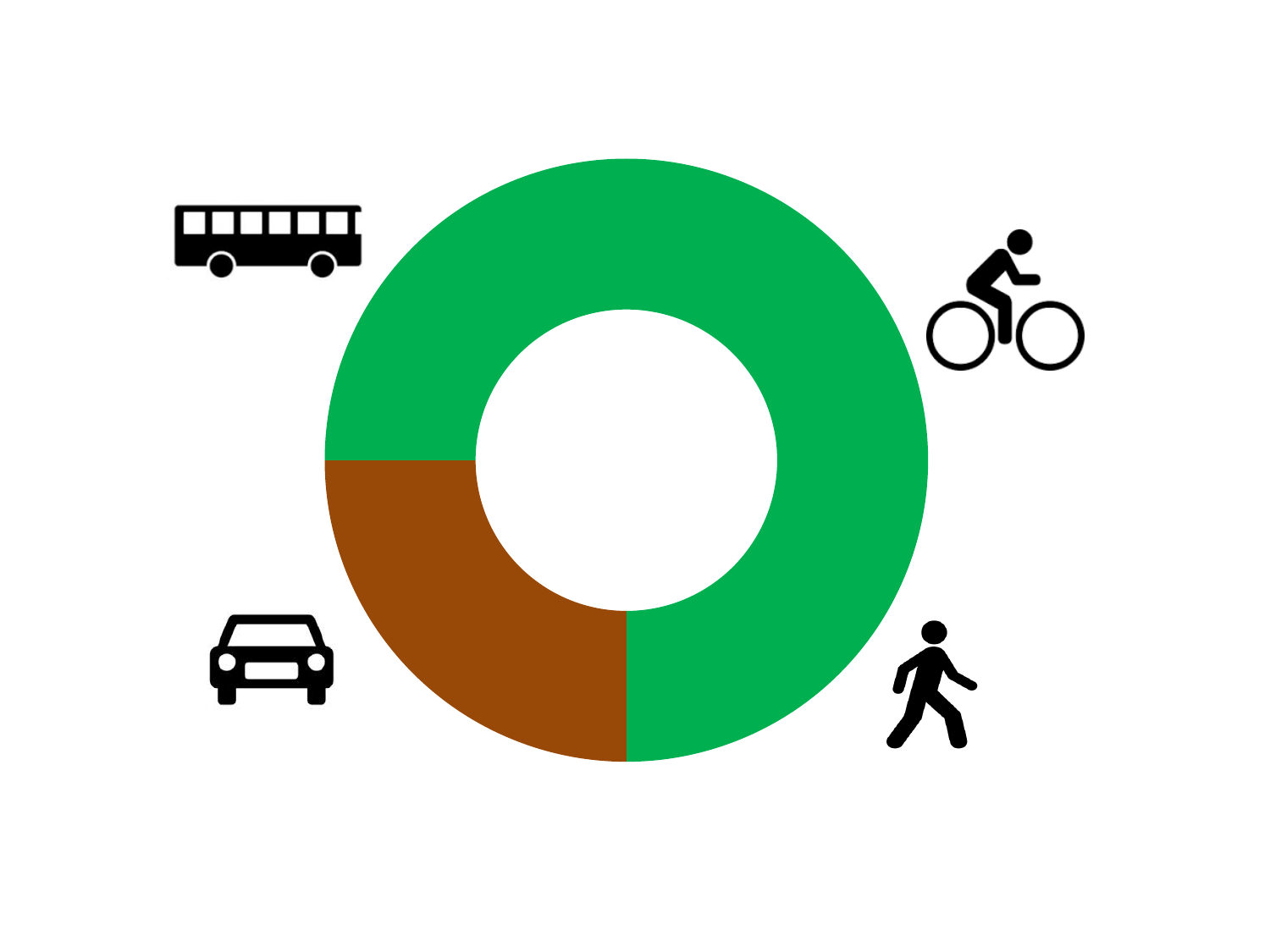
What two colours are used for the slices of the donut chart? Green and brown Which colour slice takes up the largest share of the donut chart? Green What kind of chart is shown on the slide? Donut (pie) chart Which slice of the donut chart is larger, the green one or the brown one? The green one Which colour slice takes up the smallest share of the donut chart? Brown Does the donut chart display a legend? No